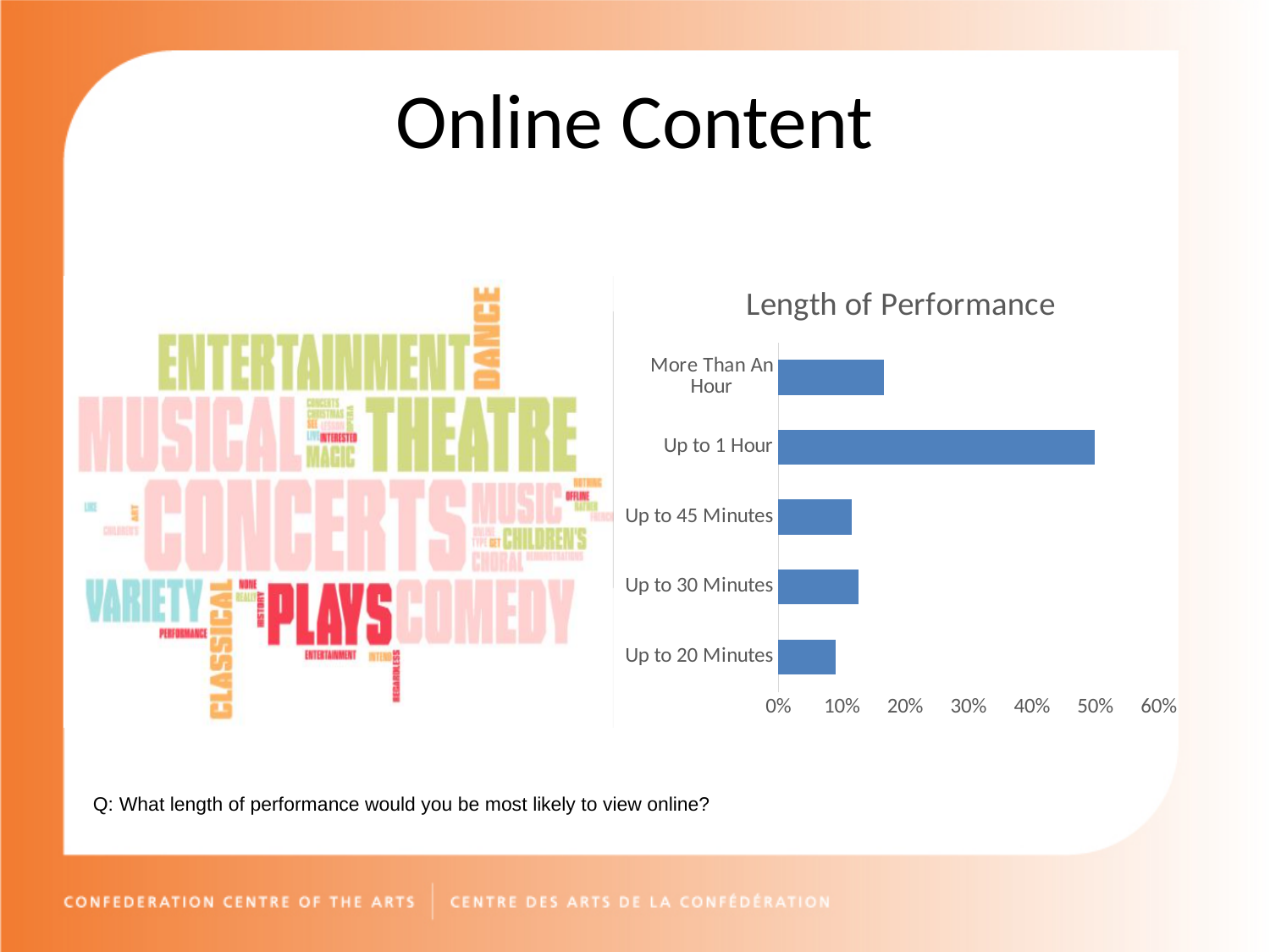
Is the value for Up to 1 Hour greater or less than 40%? greater Is the value for More Than An Hour greater or less than 10%? greater Which is larger, the value for Up to 1 Hour or the value for Up to 30 Minutes? Up to 1 Hour Which category has the highest value in the Length of Performance chart? Up to 1 Hour How many categories are shown in the Length of Performance chart? 5 What is the title of the chart on the slide? Length of Performance What is the highest value shown on the horizontal axis of the Length of Performance chart? 60% Which category has the lowest value in the Length of Performance chart? Up to 20 Minutes Is the value for Up to 45 Minutes greater or less than 20%? less What kind of chart is the Length of Performance chart? bar chart Which is larger, the value for More Than An Hour or the value for Up to 45 Minutes? More Than An Hour